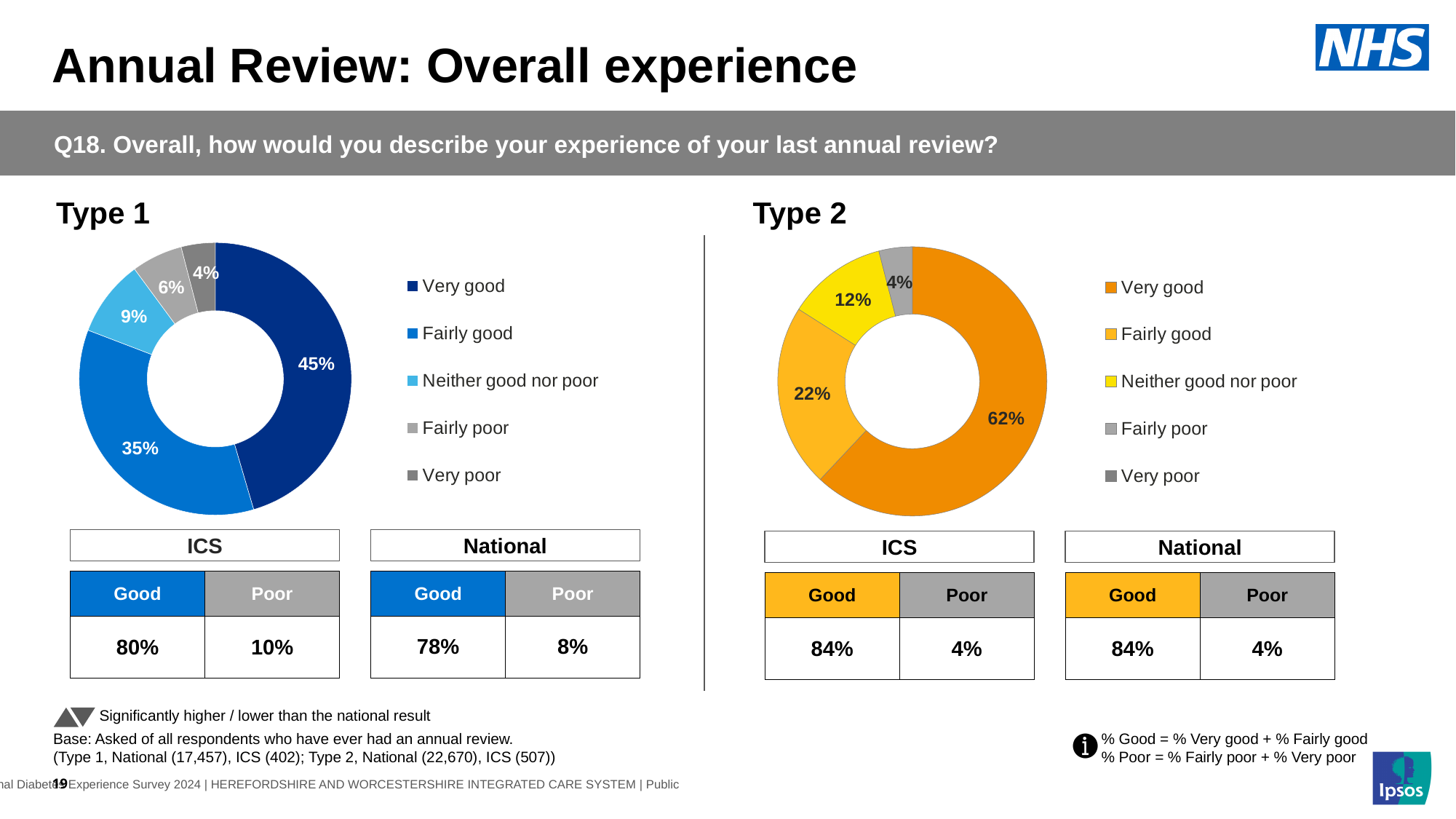
In the Type 1 chart, what percentage said Neither good nor poor? 9% What is the difference between the Very good share in the Type 2 chart and the Very good share in the Type 1 chart? 17 percentage points What kind of chart is used for the Type 2 data? Doughnut (pie) chart In the Type 2 chart, which response category has the largest share? Very good Which is larger: the Fairly good share in the Type 1 chart or the Fairly good share in the Type 2 chart? Type 1 In the Type 2 chart, what percentage of respondents said Very good? 62% In the Type 1 chart, what percentage of respondents said Fairly good? 35% In the Type 2 chart, what percentage said Fairly good? 22% In the Type 1 chart, what percentage of respondents said their experience was Very good? 45% In the Type 1 chart, which response category has the largest share? Very good In the Type 2 chart, what percentage said Neither good nor poor? 12% How many entries does the legend of the Type 1 chart list? 5